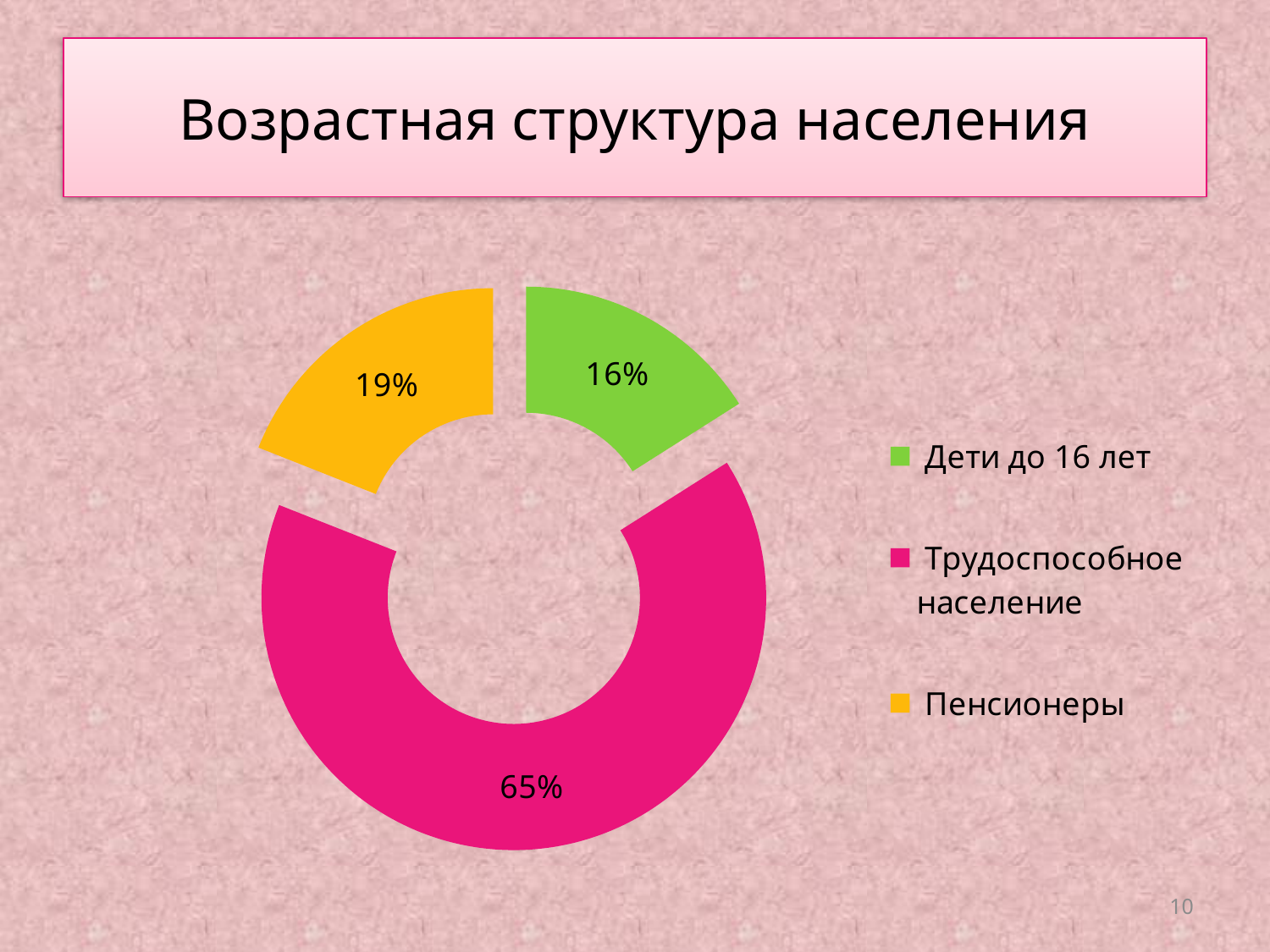
What is the title of the slide? Возрастная структура населения Which category has the largest share? Трудоспособное население What share of the population is Пенсионеры? 19% What is the difference in percentage points between Пенсионеры and Дети до 16 лет? 3 What kind of chart is shown on the slide? Doughnut (pie) chart Which colour represents Пенсионеры in the legend? Yellow Which category has the smallest share? Дети до 16 лет Which is larger, the share for Пенсионеры or the share for Дети до 16 лет? Пенсионеры What share of the population is Дети до 16 лет? 16% What share of the population is Трудоспособное население? 65% How many categories does the chart show? 3 What is the difference in percentage points between Трудоспособное население and Пенсионеры? 46